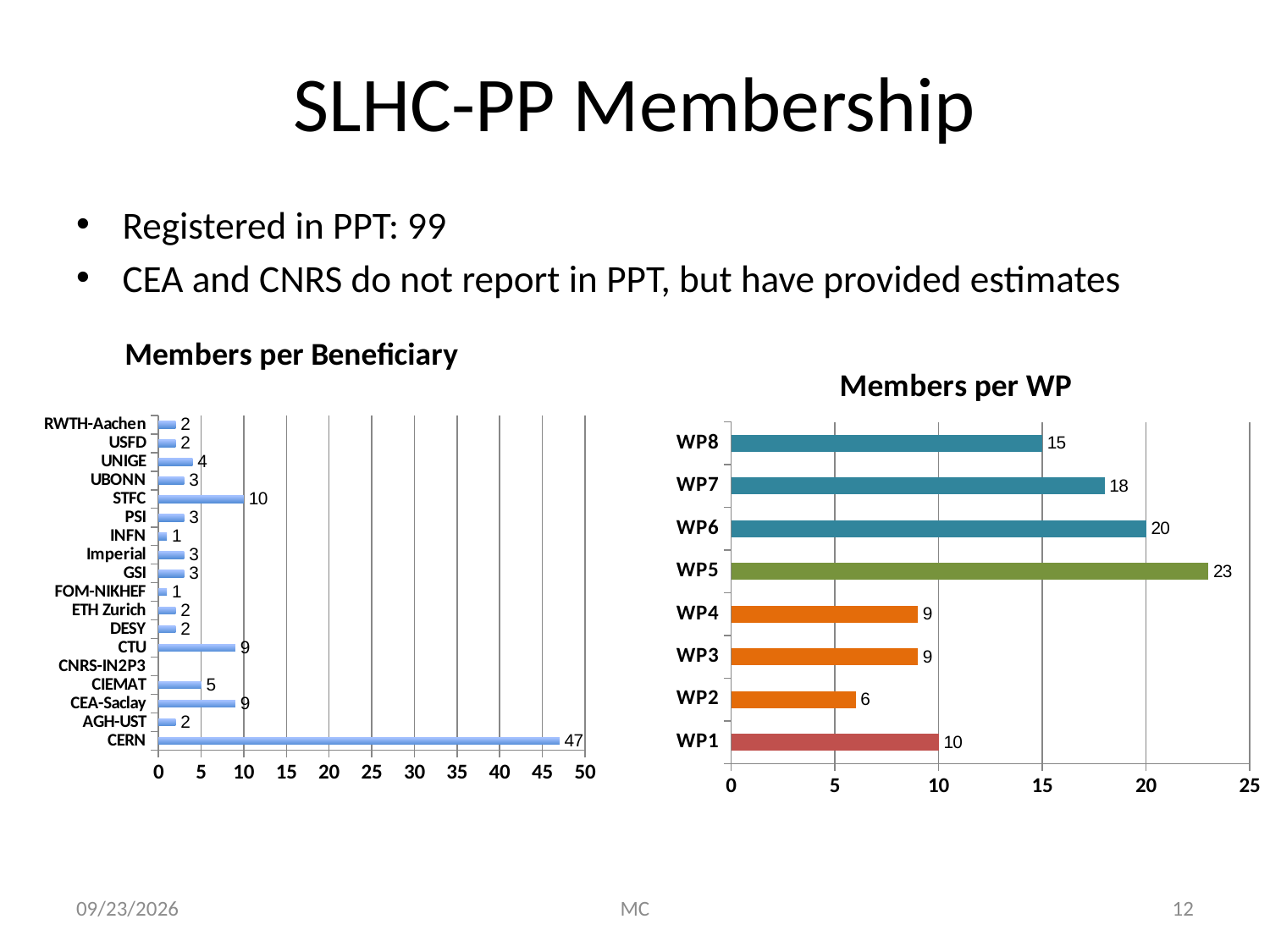
In the 'Members per Beneficiary' chart, what is the difference between the values for CERN and CTU? 38 In the 'Members per Beneficiary' chart, what is the value for STFC? 10 In the 'Members per Beneficiary' chart, what is the value for CERN? 47 In the 'Members per Beneficiary' chart, is the value for CERN greater or less than 45? greater In the 'Members per WP' chart, which is larger, the value for WP7 or the value for WP8? WP7 In the 'Members per WP' chart, which WP has the lowest number of members? WP2 In the 'Members per WP' chart, which WP has the highest number of members? WP5 What kind of chart is the 'Members per WP' chart? Bar chart In the 'Members per WP' chart, what is the difference between the values for WP6 and WP2? 14 In the 'Members per Beneficiary' chart, which beneficiary has the most members? CERN In the 'Members per WP' chart, what is the value for WP5? 23 In the 'Members per WP' chart, how many WPs are shown? 8